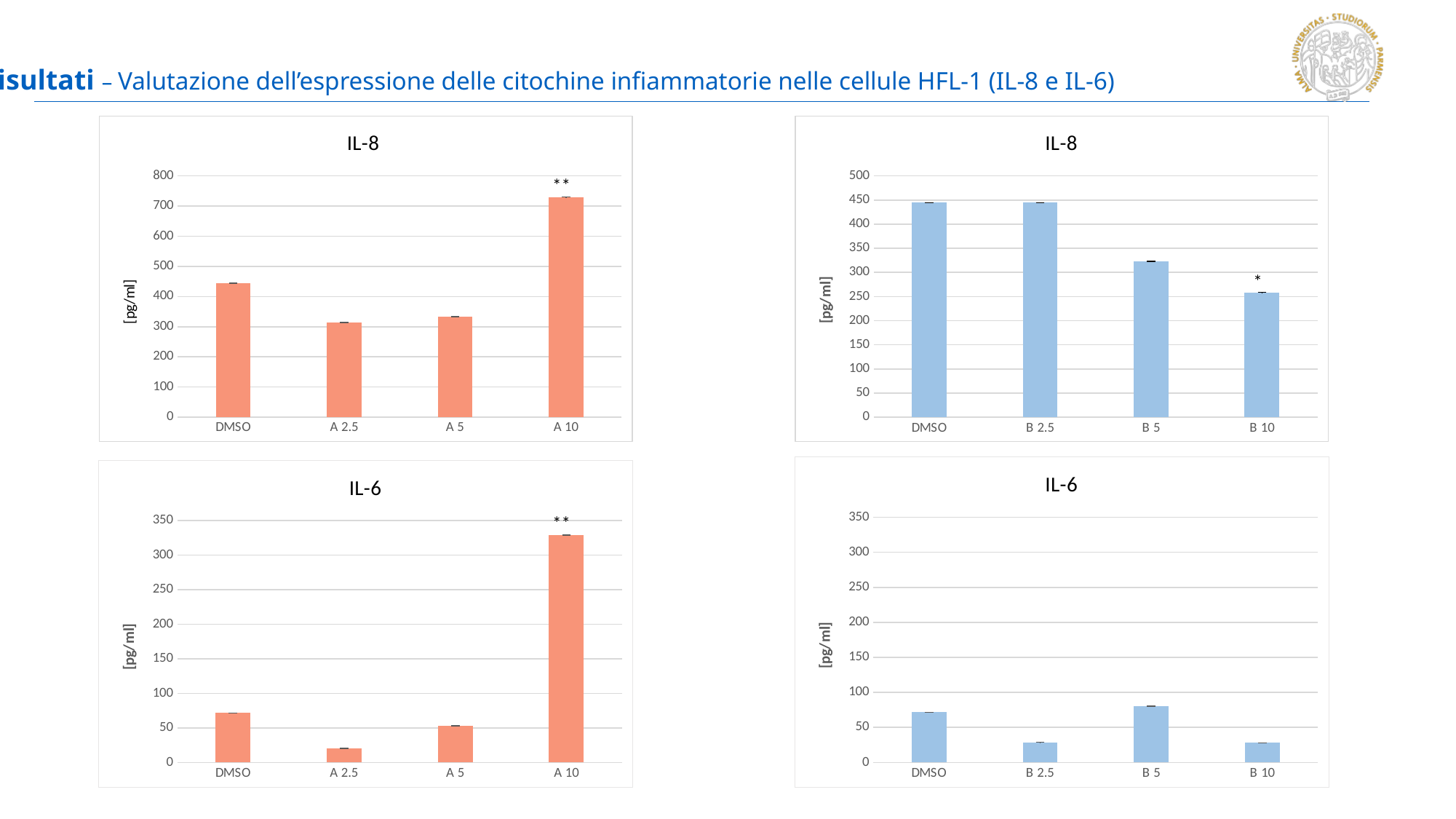
In the top-left IL-8 chart, is the value for A 10 greater or less than 700? greater In the top-right IL-8 chart, which category has the lowest value? B 10 In the bottom-left IL-6 chart, which category has the highest value? A 10 In the top-right IL-8 chart, is the value for B 10 greater or less than 300? less In the bottom-left IL-6 chart, which category has the lowest value? A 2.5 In the top-left IL-8 chart, which is larger, the value for DMSO or the value for A 5? DMSO In the top-left IL-8 chart, is the value for A 2.5 greater or less than 400? less How many categories are shown on the x axis of the bottom-right IL-6 chart? 4 In the top-left IL-8 chart, which category has the highest value? A 10